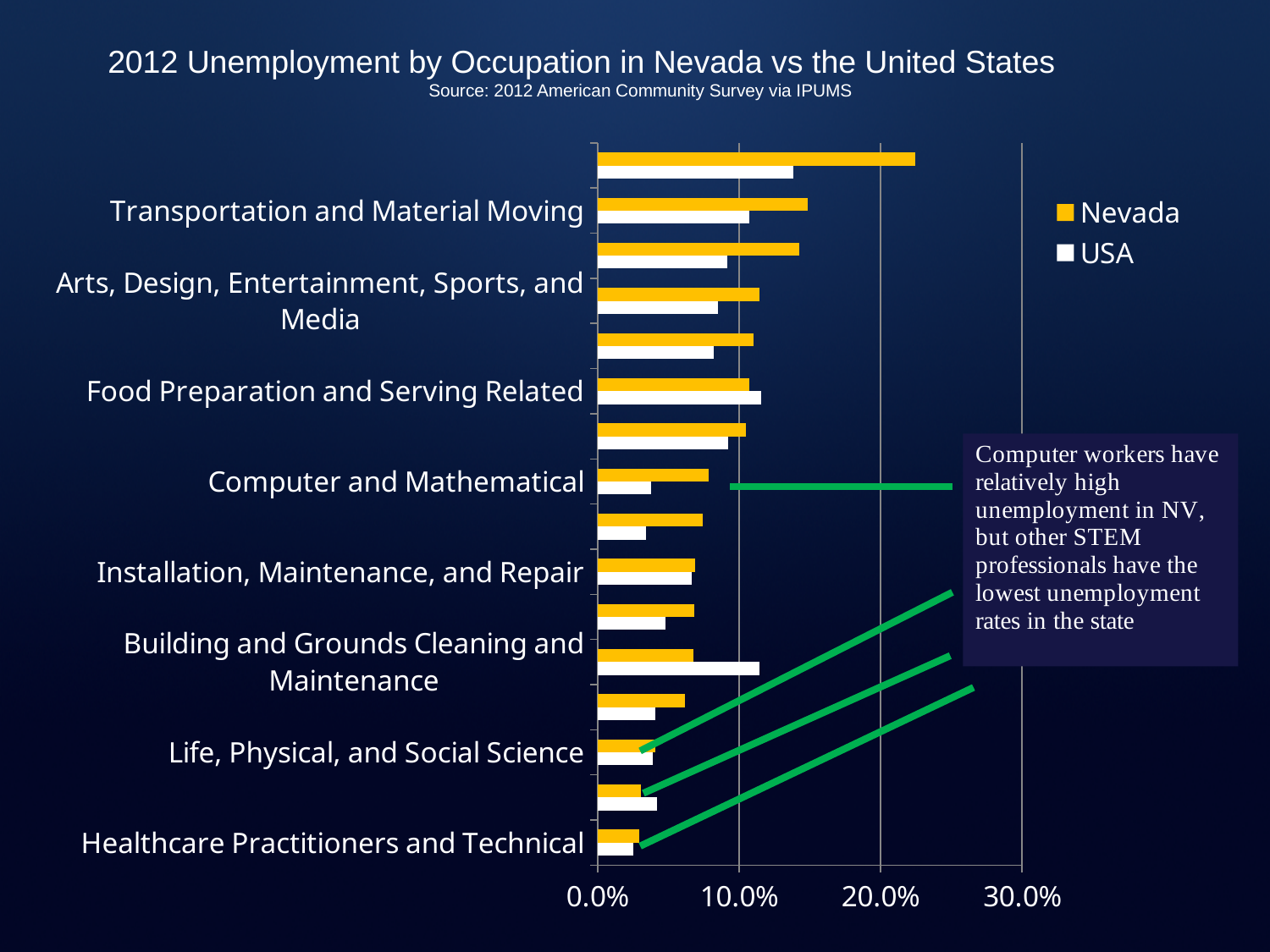
For Transportation and Material Moving, which is larger: the Nevada value or the USA value? Nevada For Computer and Mathematical, which is larger: the Nevada value or the USA value? Nevada What are the two series named in the legend? Nevada and USA How many series does the legend list? 2 Is the Nevada value for Transportation and Material Moving greater or less than 10.0%? greater Is the Nevada value for Healthcare Practitioners and Technical greater or less than 10.0%? less What kind of chart is shown on the slide? bar chart Is the USA value for Building and Grounds Cleaning and Maintenance greater or less than 10.0%? greater Do the Nevada values generally increase or decrease going from the top of the chart to the bottom? decrease What is the title of the chart? 2012 Unemployment by Occupation in Nevada vs the United States For Building and Grounds Cleaning and Maintenance, which is larger: the Nevada value or the USA value? USA